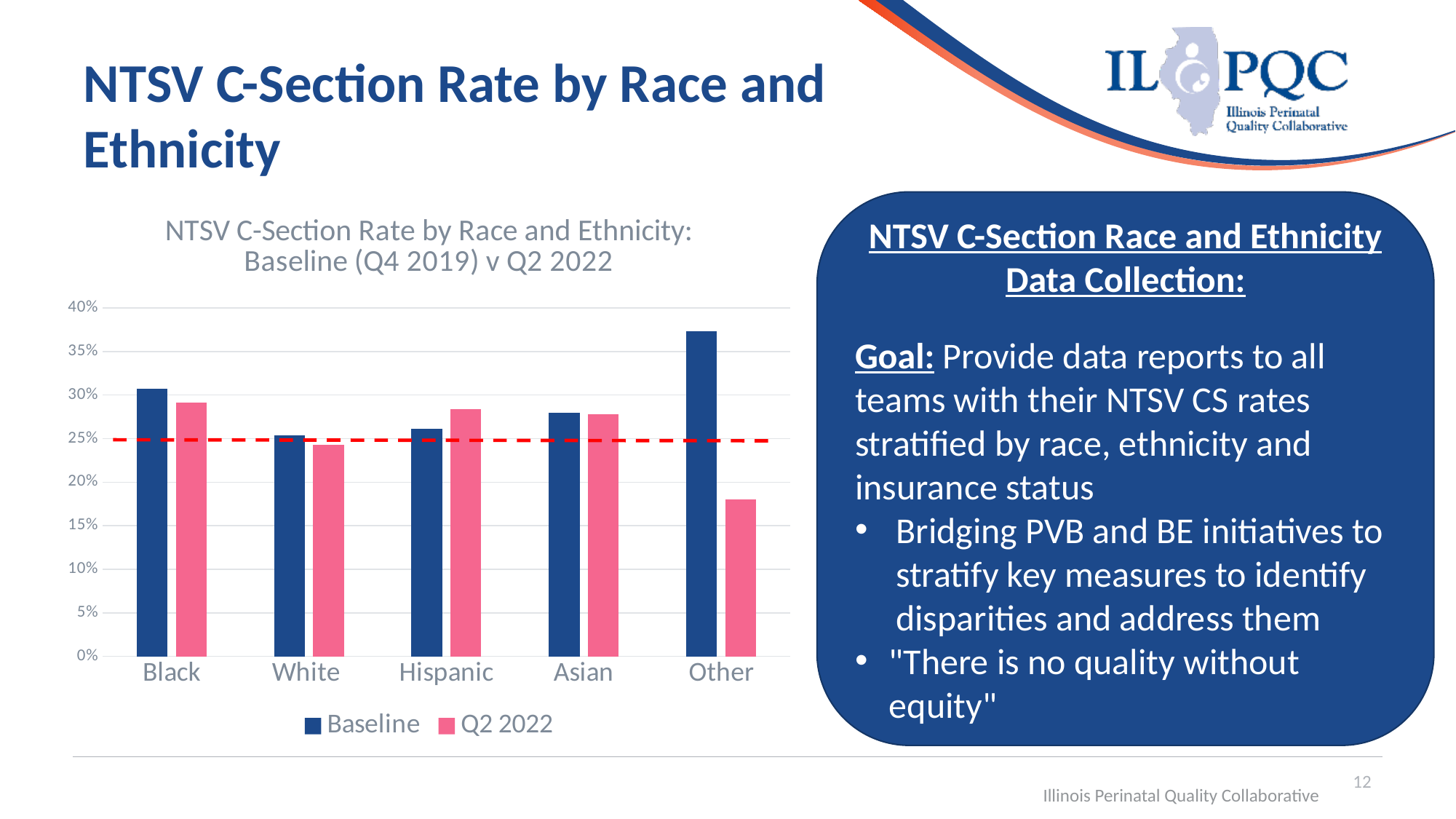
What are the two series named in the chart legend? Baseline and Q2 2022 Which category has the highest Baseline NTSV C-section rate? Other Which category has the lowest Q2 2022 NTSV C-section rate? Other For the Hispanic category, which is larger: the Baseline rate or the Q2 2022 rate? Q2 2022 What kind of chart is shown on the slide? Bar chart How many race/ethnicity categories are shown on the x axis of the chart? 5 Is the Q2 2022 value for White greater or less than 25%? less How many series does the chart legend list? 2 For the Black category, which is larger: the Baseline rate or the Q2 2022 rate? Baseline Is the Q2 2022 value for Other greater or less than 20%? less What is the title of the chart? NTSV C-Section Rate by Race and Ethnicity: Baseline (Q4 2019) v Q2 2022 Is the Baseline value for Other greater or less than 35%? greater